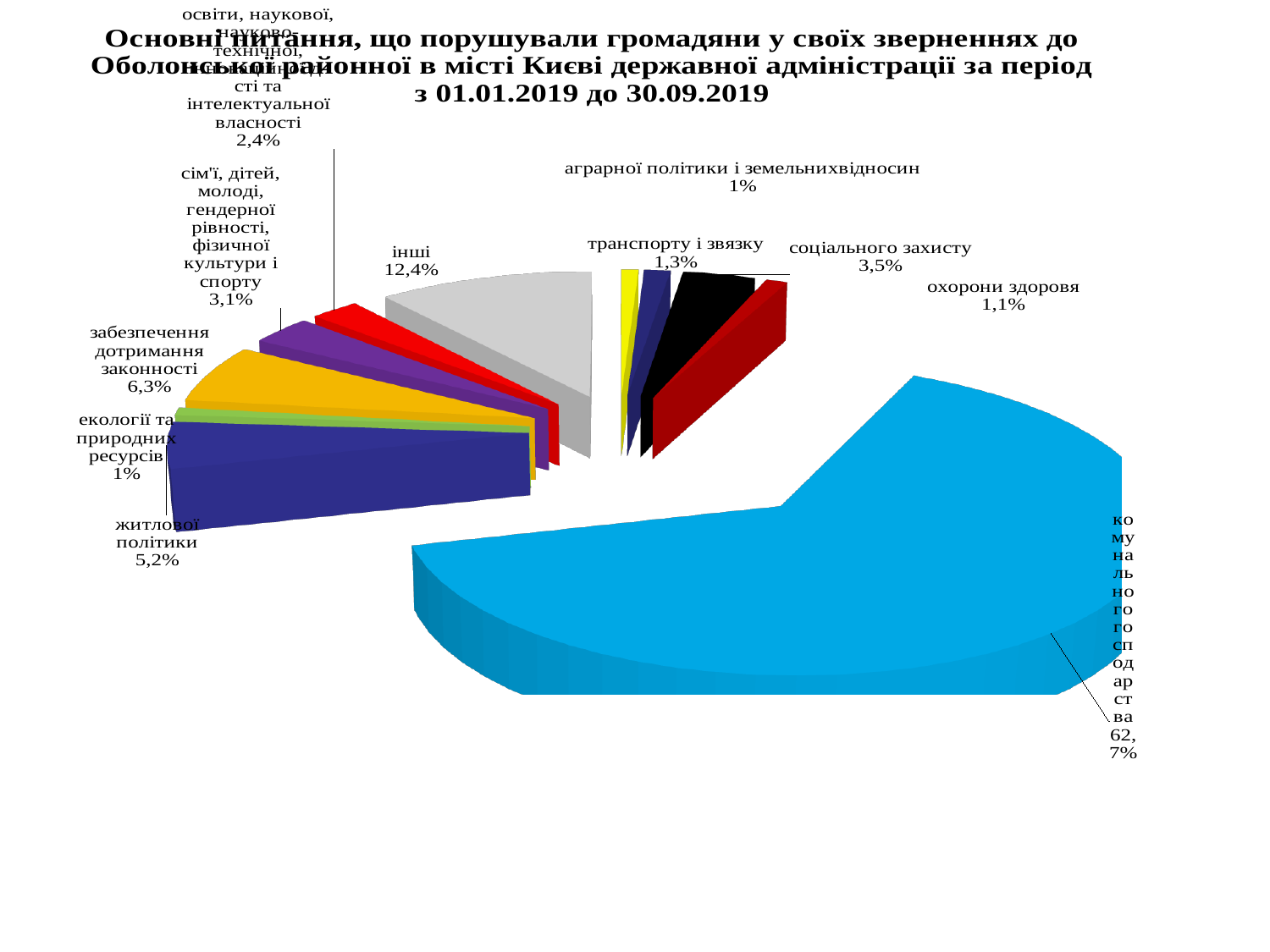
How many categories (slices) does the pie chart have? 11 What is the value shown for "забезпечення дотримання законності"? 6,3% What kind of chart is shown on the slide? pie chart Which is larger, the share for "житлової політики" or for "соціального захисту"? житлової політики What is the difference between the shares of "комунального господарства" and "інші"? 50,3% What period does the chart title say the data covers? з 01.01.2019 до 30.09.2019 What is the value shown for "охорони здоровя"? 1,1% What is the value shown for "інші"? 12,4% What share of the pie does "комунального господарства" have? 62,7% Which category has the largest share of the pie? комунального господарства What is the value shown for "соціального захисту"? 3,5% What is the value shown for "житлової політики"? 5,2%